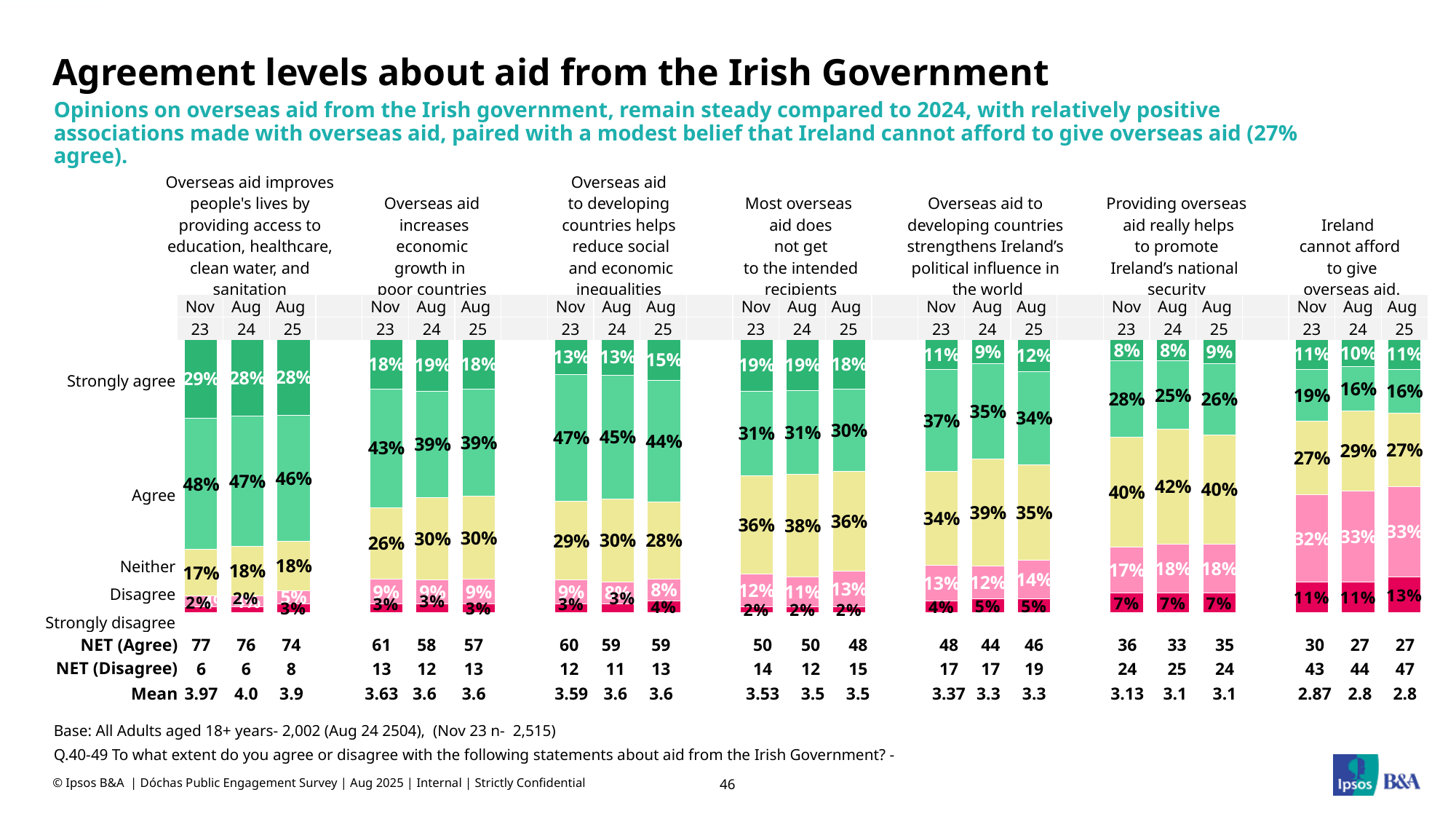
Which statement has the highest NET (Agree) in Aug 25? Overseas aid improves people's lives by providing access to education, healthcare, clean water, and sanitation How does the NET (Agree) for 'Overseas aid improves people's lives...' change from Nov 23 to Aug 25? It falls (77 to 76 to 74) What is the NET (Agree) figure for Aug 25 for the statement 'Ireland cannot afford to give overseas aid'? 27 What kind of chart is shown on the slide? Stacked bar chart Which statement has the lowest Mean score in Nov 23? Ireland cannot afford to give overseas aid What is the difference between the NET (Agree) for Nov 23 and Aug 25 for the statement 'Overseas aid increases economic growth in poor countries'? 4 What is the NET (Disagree) figure for Aug 25 for the statement 'Ireland cannot afford to give overseas aid'? 47 Which is larger: the 'Agree' share in Aug 25 for 'Overseas aid to developing countries helps reduce social and economic inequalities' or for 'Most overseas aid does not get to the intended recipients'? Overseas aid to developing countries helps reduce social and economic inequalities (44%) What percentage answered 'Neither' in Aug 24 for the statement 'Providing overseas aid really helps to promote Ireland's national security'? 42% What percentage strongly agreed in Aug 25 that overseas aid improves people's lives by providing access to education, healthcare, clean water, and sanitation? 28% How many response categories are labelled on the left of the chart? 5 How many statements about aid from the Irish Government are shown in the chart? 7